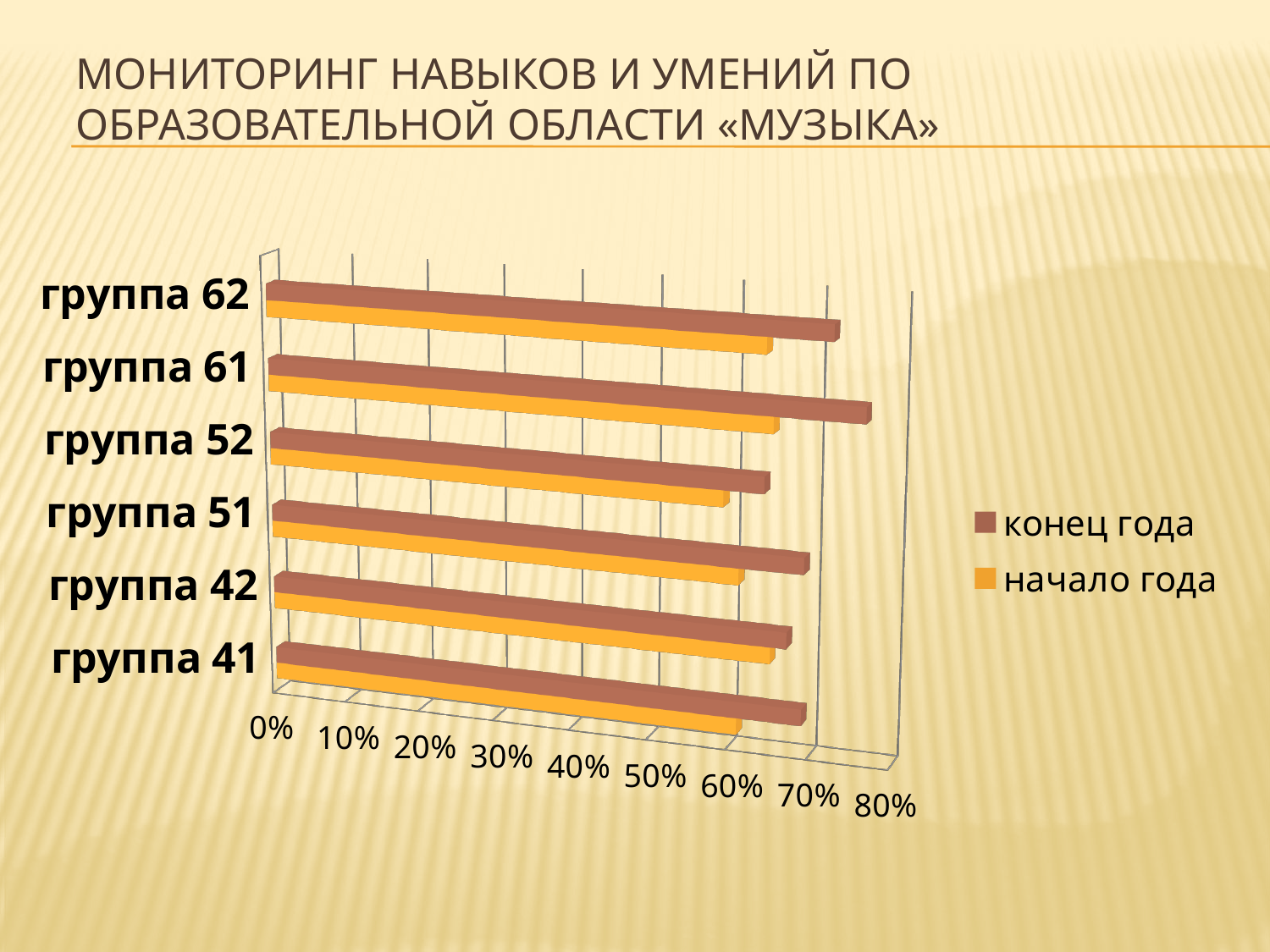
For группа 61, which is larger: the "конец года" value or the "начало года" value? конец года Is the "конец года" value for группа 61 greater or less than 70%? greater How many series does the legend list? 2 Which group has the highest value for "конец года"? группа 61 Is the "начало года" value for группа 62 greater or less than 50%? greater Is the "конец года" value for группа 52 greater or less than 70%? less Which group has the lowest value for "конец года"? группа 52 Which series is shown in orange in the legend? начало года What kind of chart is shown on the slide? bar chart How many groups (categories) are plotted on the chart? 6 What is the highest value shown on the percentage axis? 80%